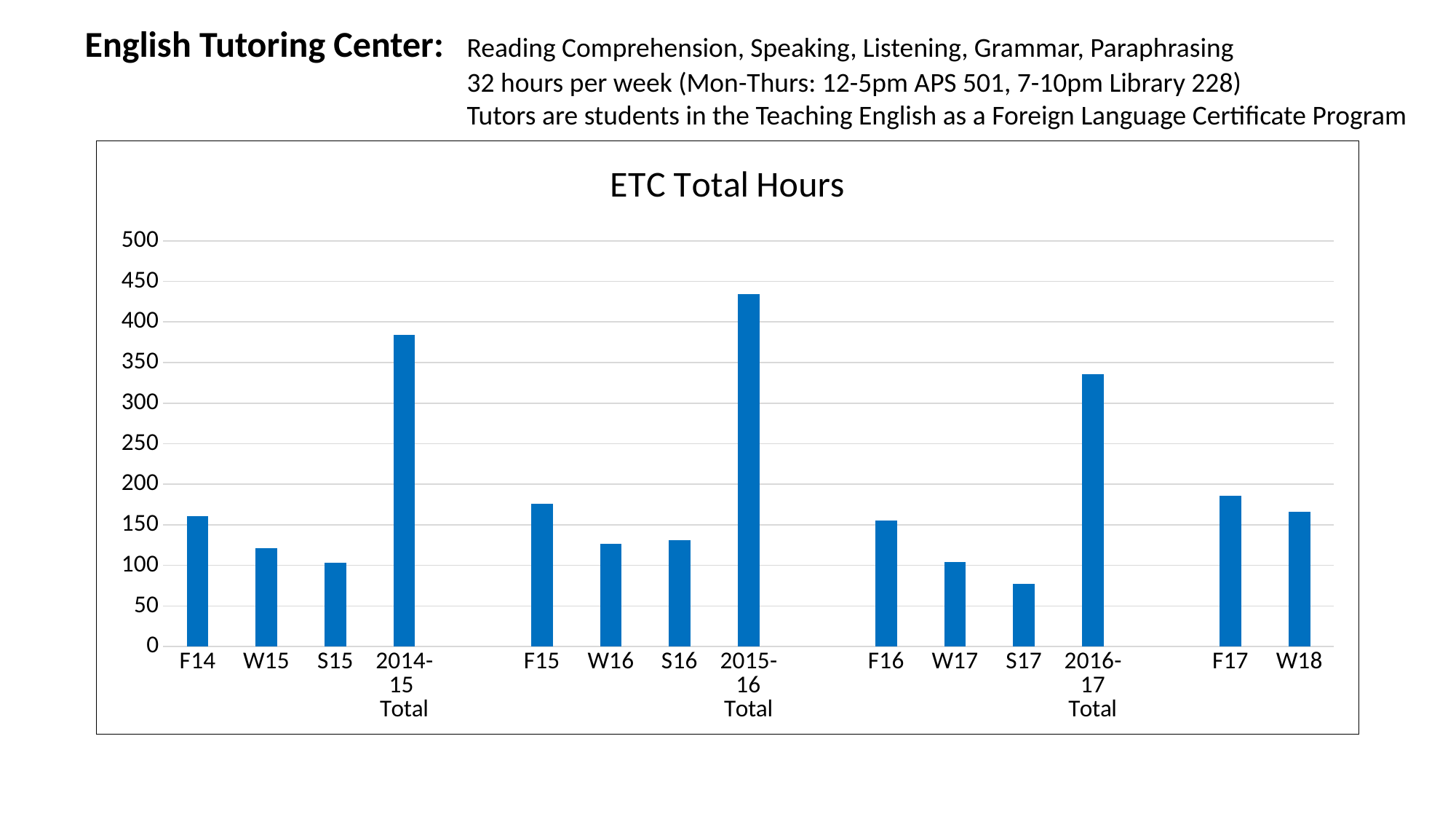
Which category has the highest value in the chart? 2015-16 Total Which category has the lowest value in the chart? S17 Do the values rise or fall across F14, W15 and S15? fall Which is larger, the value for F15 or the value for W16? F15 How many categories are shown on the x axis of the chart? 14 Is the value for S17 greater or less than 100? less Is the value for 2015-16 Total greater or less than 400? greater What is the title of the chart? ETC Total Hours Which is larger, the value for 2014-15 Total or the value for 2016-17 Total? 2014-15 Total What type of chart is shown on the slide? bar chart Is the value for 2016-17 Total greater or less than 300? greater